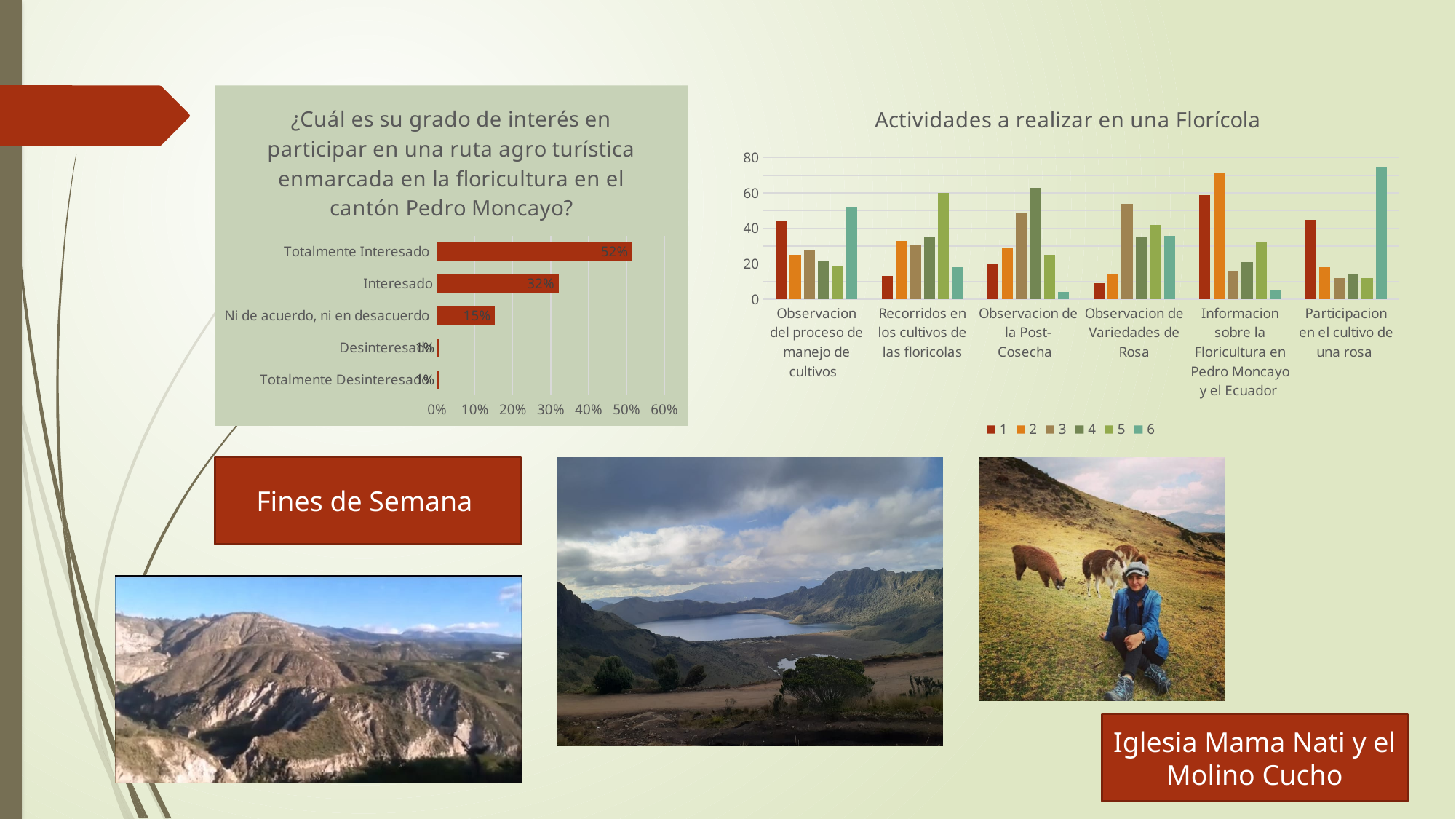
In the chart '¿Cuál es su grado de interés en participar en una ruta agro turística...', which category has the highest value? Totalmente Interesado What kind of chart is '¿Cuál es su grado de interés en participar en una ruta agro turística...'? Bar chart How many series does the legend list in the chart 'Actividades a realizar en una Florícola'? 6 In the chart 'Actividades a realizar en una Florícola', is the value of series 1 for 'Recorridos en los cultivos de las floricolas' greater or less than 20? less In the chart '¿Cuál es su grado de interés en participar en una ruta agro turística...', what is the value for 'Totalmente Interesado'? 52% How many categories are shown in the chart '¿Cuál es su grado de interés en participar en una ruta agro turística...'? 5 In the chart '¿Cuál es su grado de interés en participar en una ruta agro turística...', what is the difference between 'Totalmente Interesado' and 'Interesado'? 20 percentage points In the chart 'Actividades a realizar en una Florícola', is the value of series 6 for 'Participacion en el cultivo de una rosa' greater or less than 60? greater In the chart '¿Cuál es su grado de interés en participar en una ruta agro turística...', what is the value for 'Ni de acuerdo, ni en desacuerdo'? 15% In the chart 'Actividades a realizar en una Florícola', for 'Observacion del proceso de manejo de cultivos', which is larger: series 1 or series 2? Series 1 How many categories are shown on the x axis of the chart 'Actividades a realizar en una Florícola'? 6 In the chart '¿Cuál es su grado de interés en participar en una ruta agro turística...', what is the value for 'Interesado'? 32%